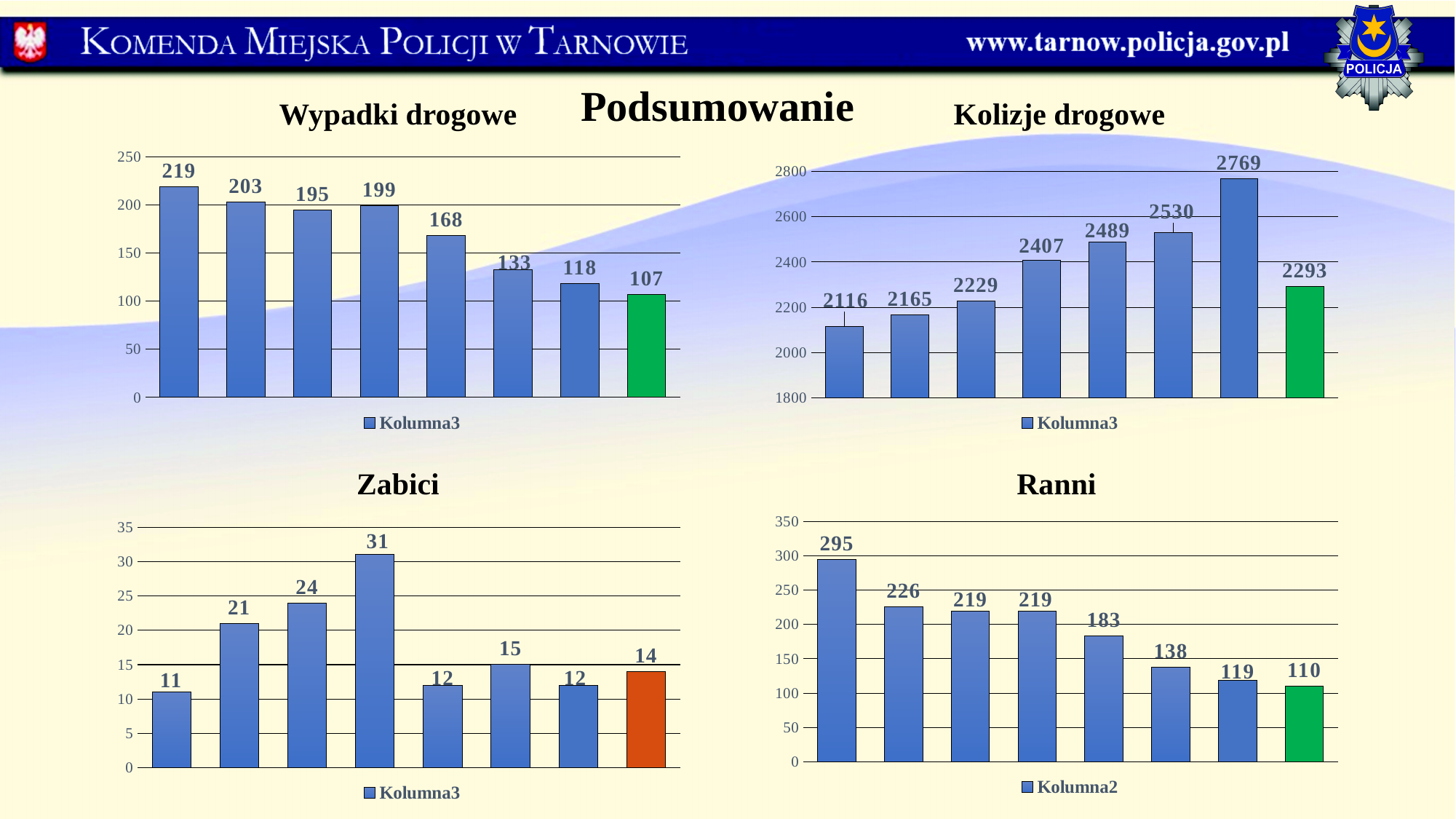
In the 'Zabici' chart, what is the highest value shown? 31 In the 'Kolizje drogowe' chart, what is the highest value shown? 2769 In the 'Wypadki drogowe' chart, what is the highest value shown? 219 In the 'Ranni' chart, what is the difference between the first bar and the green (last) bar? 185 In the 'Kolizje drogowe' chart, what is the difference between the highest bar and the green (last) bar? 476 In the 'Ranni' chart, do the values generally rise or fall from left to right? fall How many bars are plotted in the 'Zabici' chart? 8 What legend entry is shown under the 'Ranni' chart? Kolumna2 In the 'Wypadki drogowe' chart, what is the value of the green (last) bar? 107 In the 'Kolizje drogowe' chart, what is the lowest value shown? 2116 In the 'Zabici' chart, what is the value of the orange (last) bar? 14 In the 'Ranni' chart, what is the value of the first bar? 295